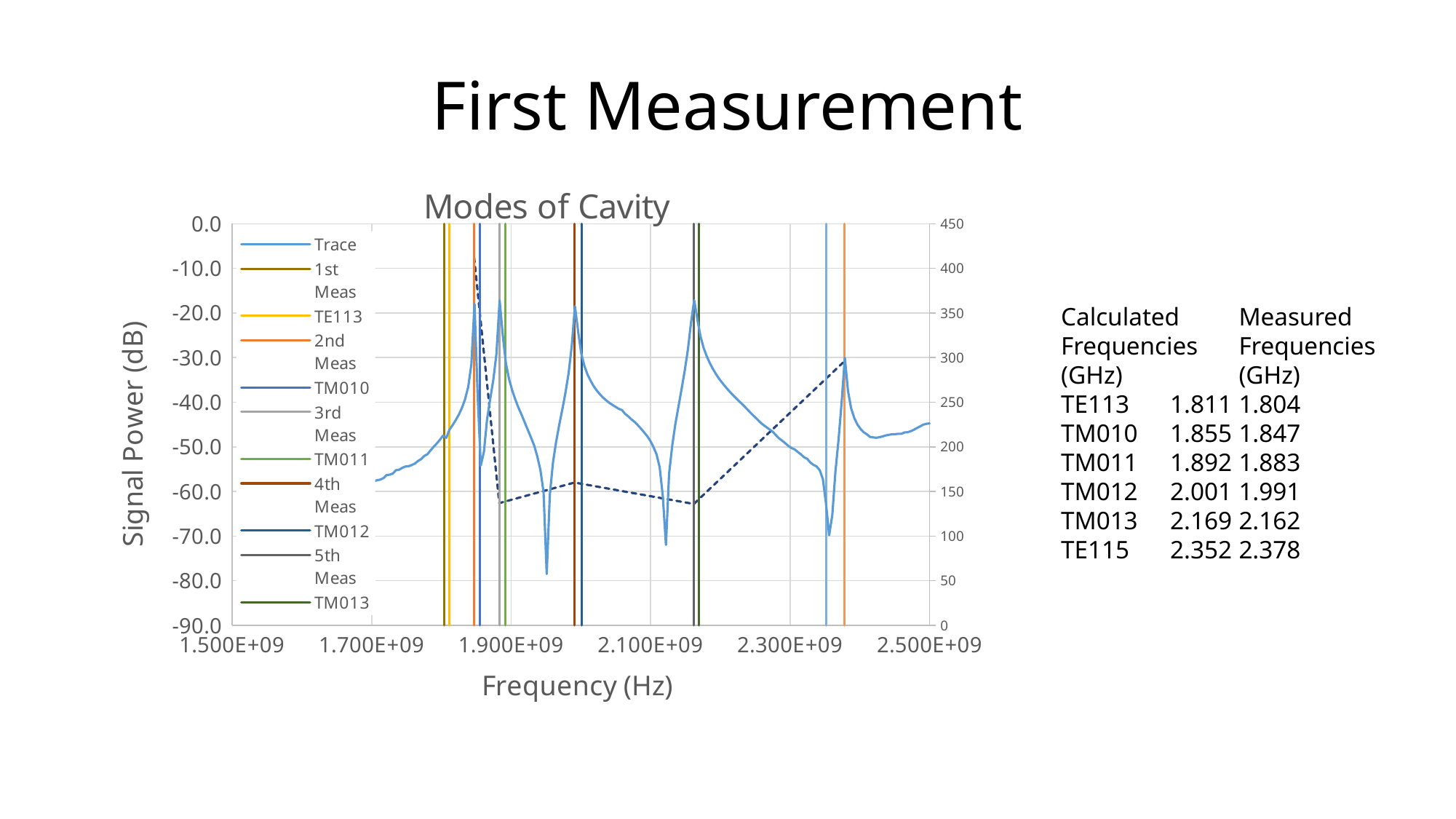
What is the highest tick value shown on the horizontal axis? 2.500E+09 What is the label of the chart's left vertical axis? Signal Power (dB) How many entries does the chart's legend list? 11 What kind of chart is shown on the slide? line chart Does the Trace line rise or fall between 1.700E+09 Hz and 1.850E+09 Hz? rise How many legend entries are labelled as measurements ("Meas")? 5 What is the highest tick value shown on the right-hand vertical axis? 450 Is the value of the Trace line at 2.500E+09 Hz greater or less than -50.0 dB? greater Is the value of the Trace line at 1.700E+09 Hz greater or less than -50.0 dB? less What is the lowest tick value shown on the left-hand vertical axis? -90.0 Is the lowest point of the Trace line, near 1.950E+09 Hz, greater or less than -70.0 dB? less What is the title of the chart? Modes of Cavity